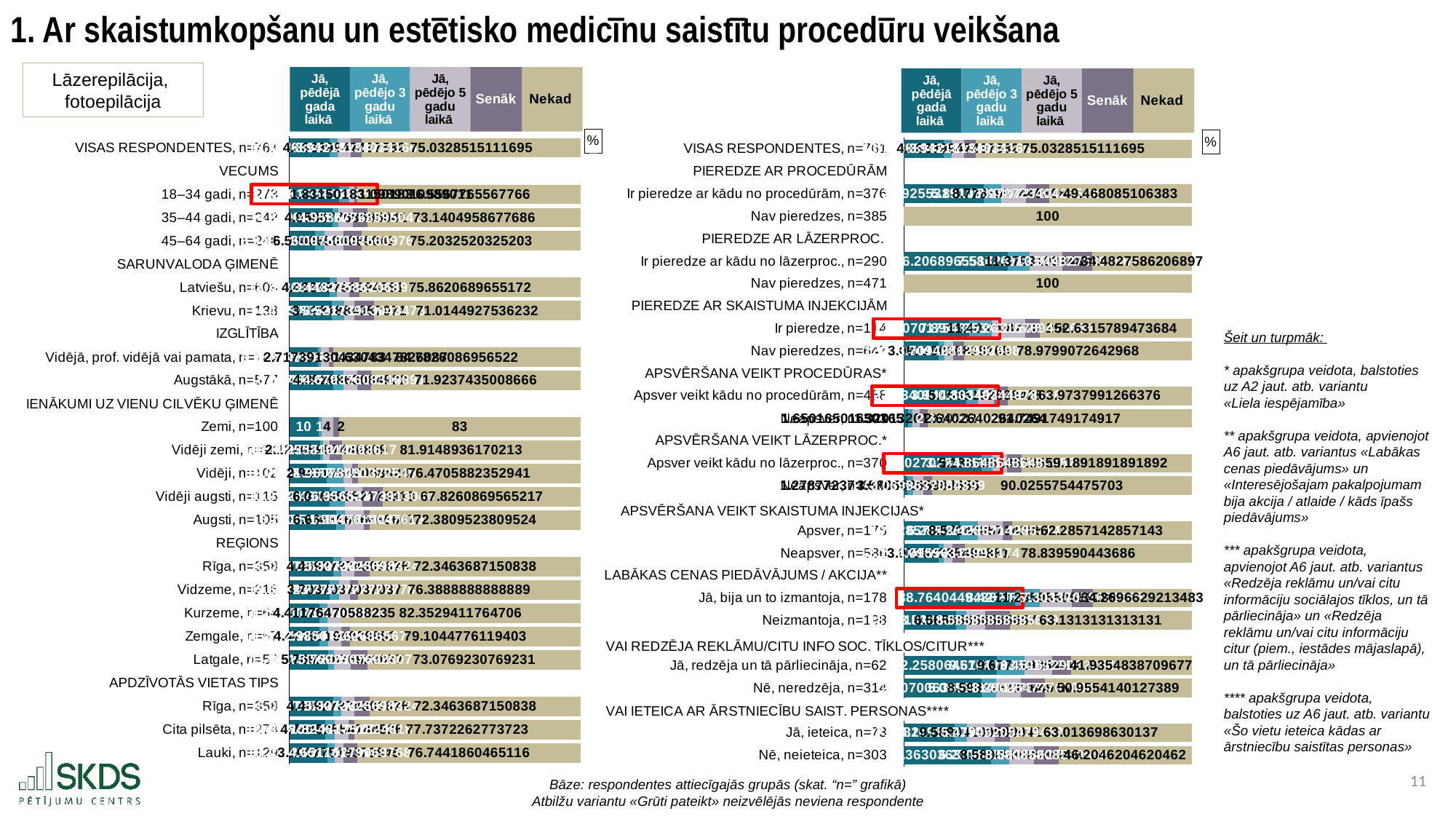
In the right chart, what is the 'Nekad' value for 'Nē, neieteica, n=303'? 46.2046204620462 In the right chart, what is the 'Nekad' value for 'Ir pieredze ar kādu no lāzerproc., n=290'? 34.4827586206897 In the left chart, what is the 'Nekad' value for the income group Zemi, n=100? 83 In the left chart, which income group has the lowest 'Nekad' value? Vidēji augsti In the right chart, which has the larger 'Nekad' value: 'Jā, bija un to izmantoja, n=178' or 'Neizmantoja, n=198'? Neizmantoja, n=198 In the right chart, what is the 'Nekad' value for 'Neapsver, n=586' under APSVĒRŠANA VEIKT SKAISTUMA INJEKCIJAS? 78.839590443686 In the left chart, which region (Rīga, Vidzeme, Kurzeme, Zemgale, Latgale) has the highest 'Nekad' value? Kurzeme In the left chart, what is the 'Nekad' value for VISAS RESPONDENTES? 75.0328515111695 In the left chart, what is the 'Nekad' value for Kurzeme? 82.3529411764706 How many response categories does the legend of the left chart list? 5 In the right chart, what is the 'Nekad' value for 'Nav pieredzes, n=385'? 100 What kind of chart is used on the slide to show the responses for Lāzerepilācija, fotoepilācija? bar chart